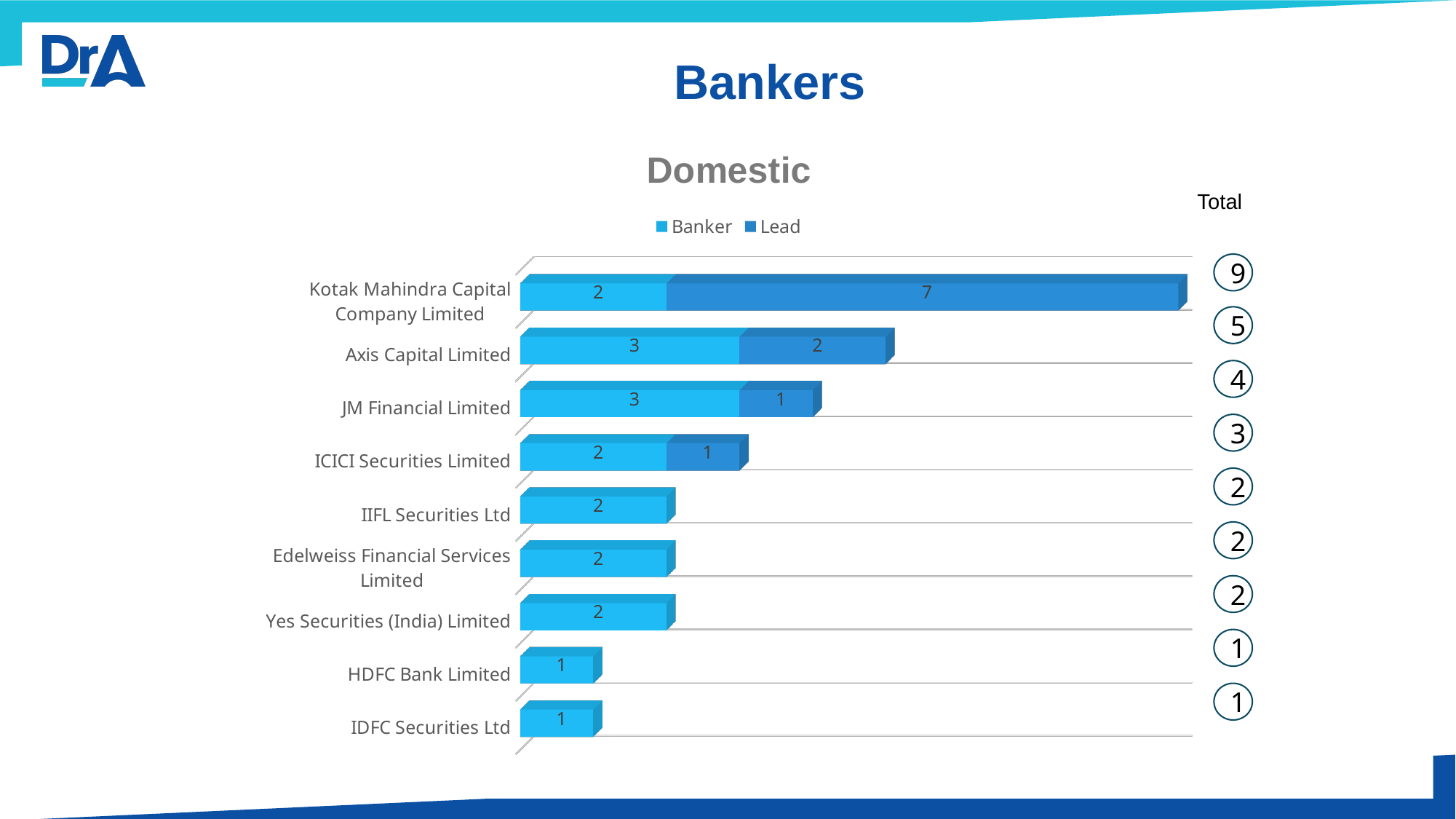
How many series does the legend list? 2 What is the Lead value for JM Financial Limited? 1 What is the Banker value for IDFC Securities Ltd? 1 What is the Banker value for Axis Capital Limited? 3 What is the Lead value for Kotak Mahindra Capital Company Limited? 7 Which is larger, the Banker value for JM Financial Limited or the Banker value for ICICI Securities Limited? JM Financial Limited Which banker has the highest total? Kotak Mahindra Capital Company Limited What is the difference between the Lead values for Kotak Mahindra Capital Company Limited and Axis Capital Limited? 5 How many bankers are listed in the chart? 9 What is the total for Axis Capital Limited? 5 What kind of chart is shown on the slide? Bar chart What is the total for ICICI Securities Limited? 3